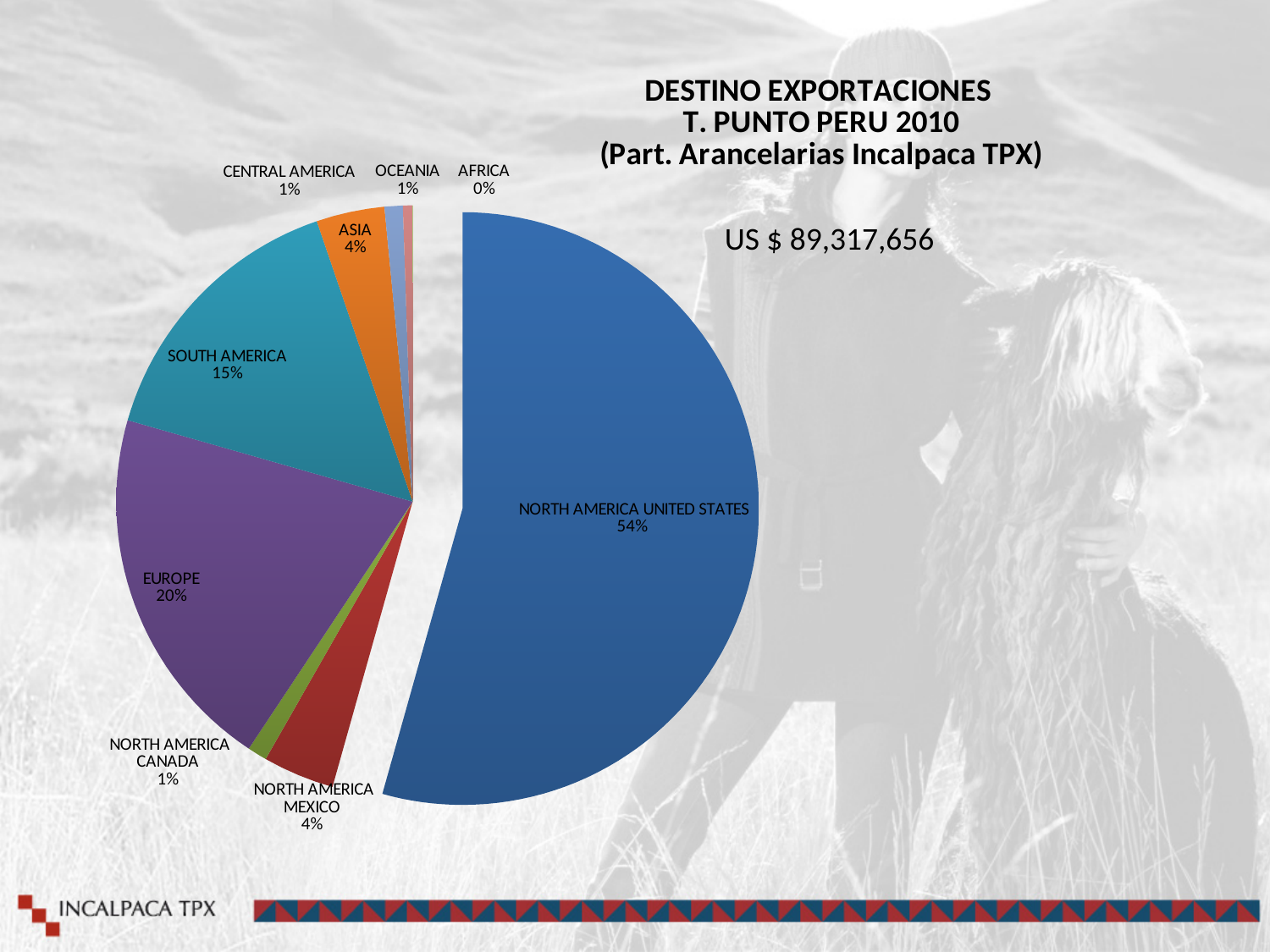
Which destination has the largest share of exports? North America United States Which has a larger share, Europe or South America? Europe What is the title of the chart? DESTINO EXPORTACIONES T. PUNTO PERU 2010 (Part. Arancelarias Incalpaca TPX) What share of exports goes to Asia? 4% What total export value is shown on the slide? US $ 89,317,656 What is the difference in share between Europe and South America? 5% What share of exports goes to Europe? 20% How many destination categories are shown in the pie chart? 9 What share of exports goes to South America? 15% What share of exports goes to North America United States? 54% Which destination has the smallest share of exports? Africa What kind of chart is shown on the slide? pie chart